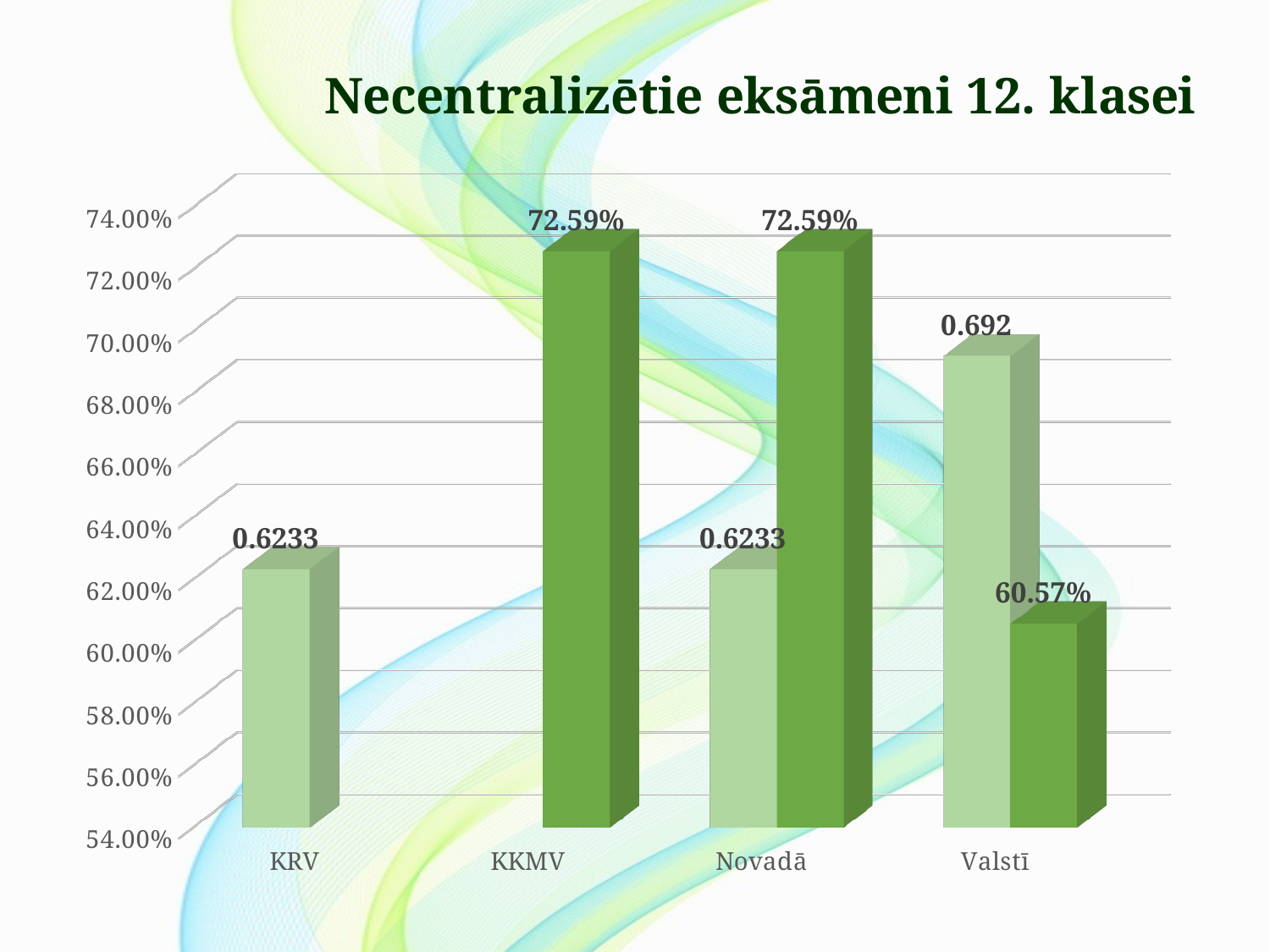
Which category has the lowest bar in the chart? Valstī What is the difference between the KKMV bar (72.59%) and the dark green Valstī bar (60.57%)? 12.02% How many bars are plotted in the chart in total? 6 Is the value for KRV greater or less than 64.00%? less What kind of chart is shown on the slide? bar chart What value is labelled on the bar for KRV? 0.6233 How many categories are shown on the x axis of the chart? 4 What value is labelled on the light green bar for Valstī? 0.692 What is the title of the chart? Necentralizētie eksāmeni 12. klasei Which is larger, the bar for KRV or the bar for KKMV? KKMV What value is labelled on the dark green bar for Valstī? 60.57% What value is labelled on the bar for KKMV? 72.59%